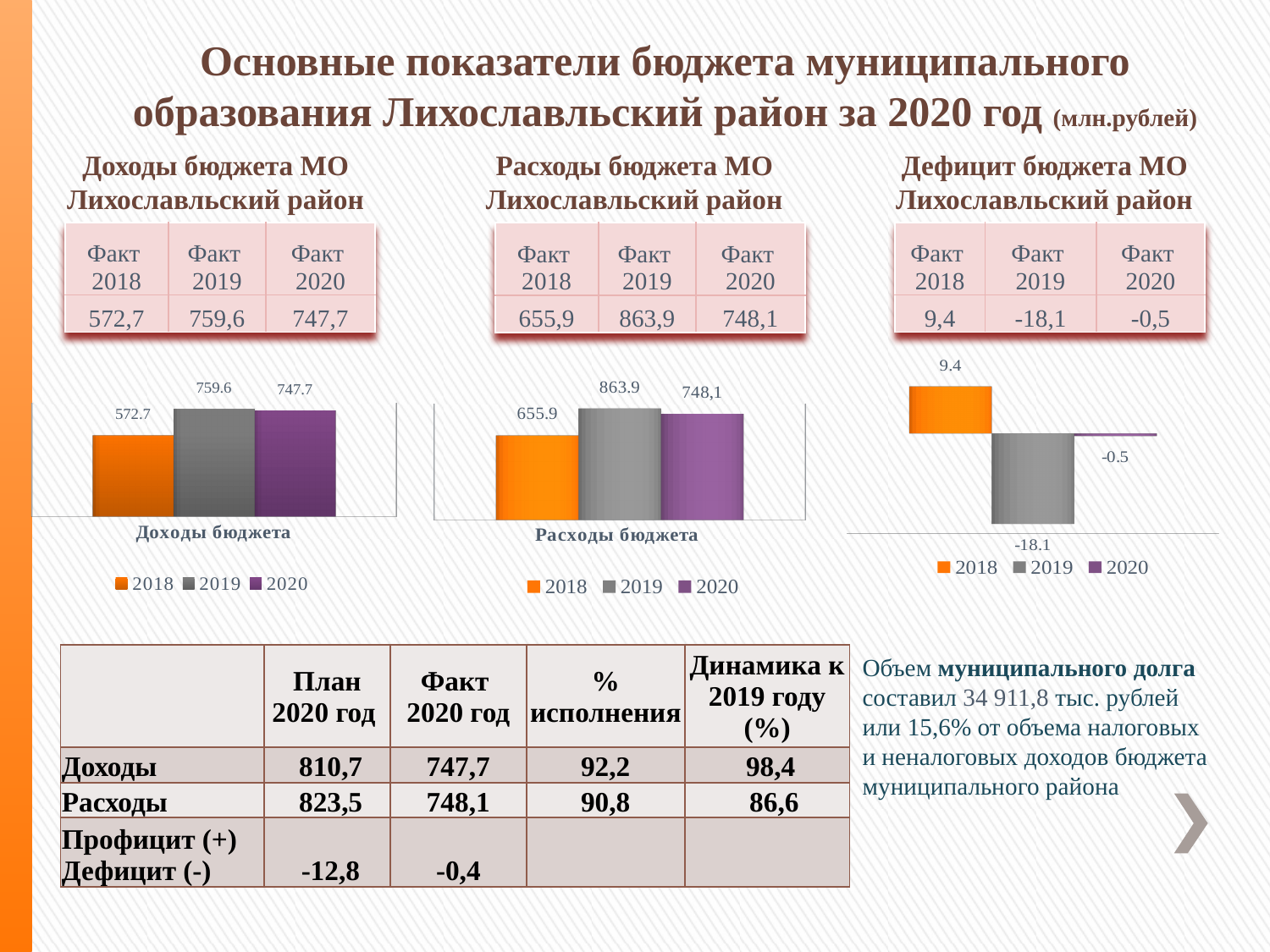
On the right chart (Дефицит бюджета), which year has the lowest value? 2019 What kind of chart is the middle chart (Расходы бюджета)? bar chart On the left chart (Доходы бюджета), what is the difference between the 2019 and 2018 values? 186.9 On the middle chart (Расходы бюджета), what is the value for 2019? 863.9 On the right chart (Дефицит бюджета), what is the value for 2018? 9.4 On the middle chart (Расходы бюджета), which year has the lowest value? 2018 On the left chart (Доходы бюджета), which colour represents 2018? orange On the left chart (Доходы бюджета), which year has the highest value? 2019 On the left chart (Доходы бюджета), what is the value for 2018? 572.7 How many series does the legend of the left chart (Доходы бюджета) list? 3 On the right chart (Дефицит бюджета), what is the value for 2019? -18.1 On the middle chart (Расходы бюджета), which is larger, the value for 2019 or the value for 2020? 2019